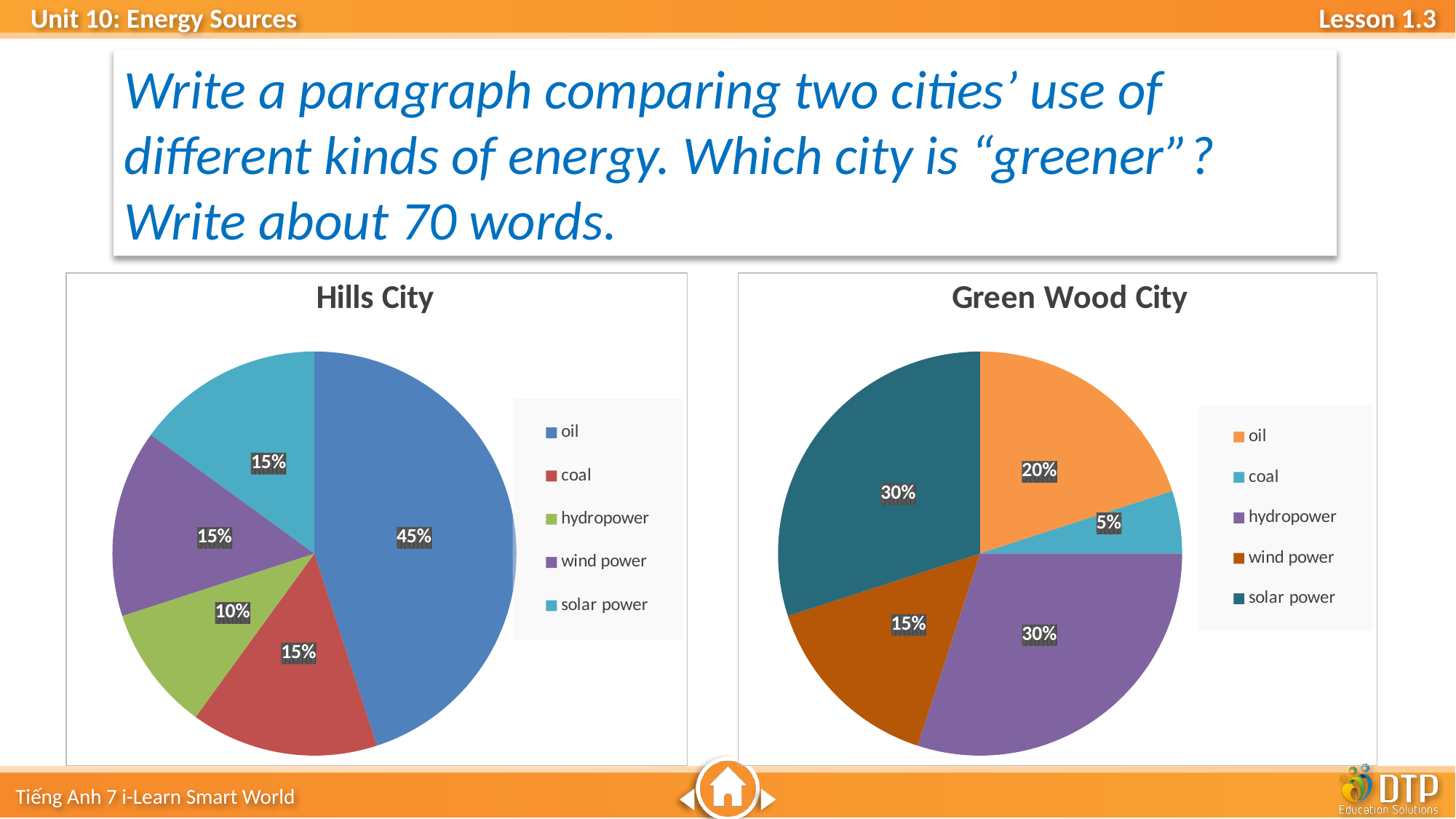
How many energy sources are shown in the Green Wood City chart? 5 In the Hills City chart, which energy source has the largest share? oil In the Hills City chart, what share of energy comes from oil? 45% What is the title of the chart on the right side of the slide? Green Wood City In the Green Wood City chart, what share of energy comes from solar power? 30% In the Hills City chart, what share of energy comes from hydropower? 10% Which is larger: the hydropower share in the Green Wood City chart or the hydropower share in the Hills City chart? Green Wood City In the Hills City chart, which energy source has the smallest share? hydropower What type of chart is the Hills City chart? pie chart What is the difference between the oil share in the Hills City chart and the oil share in the Green Wood City chart? 25% In the Green Wood City chart, which energy source has the smallest share? coal In the Green Wood City chart, what share of energy comes from coal? 5%